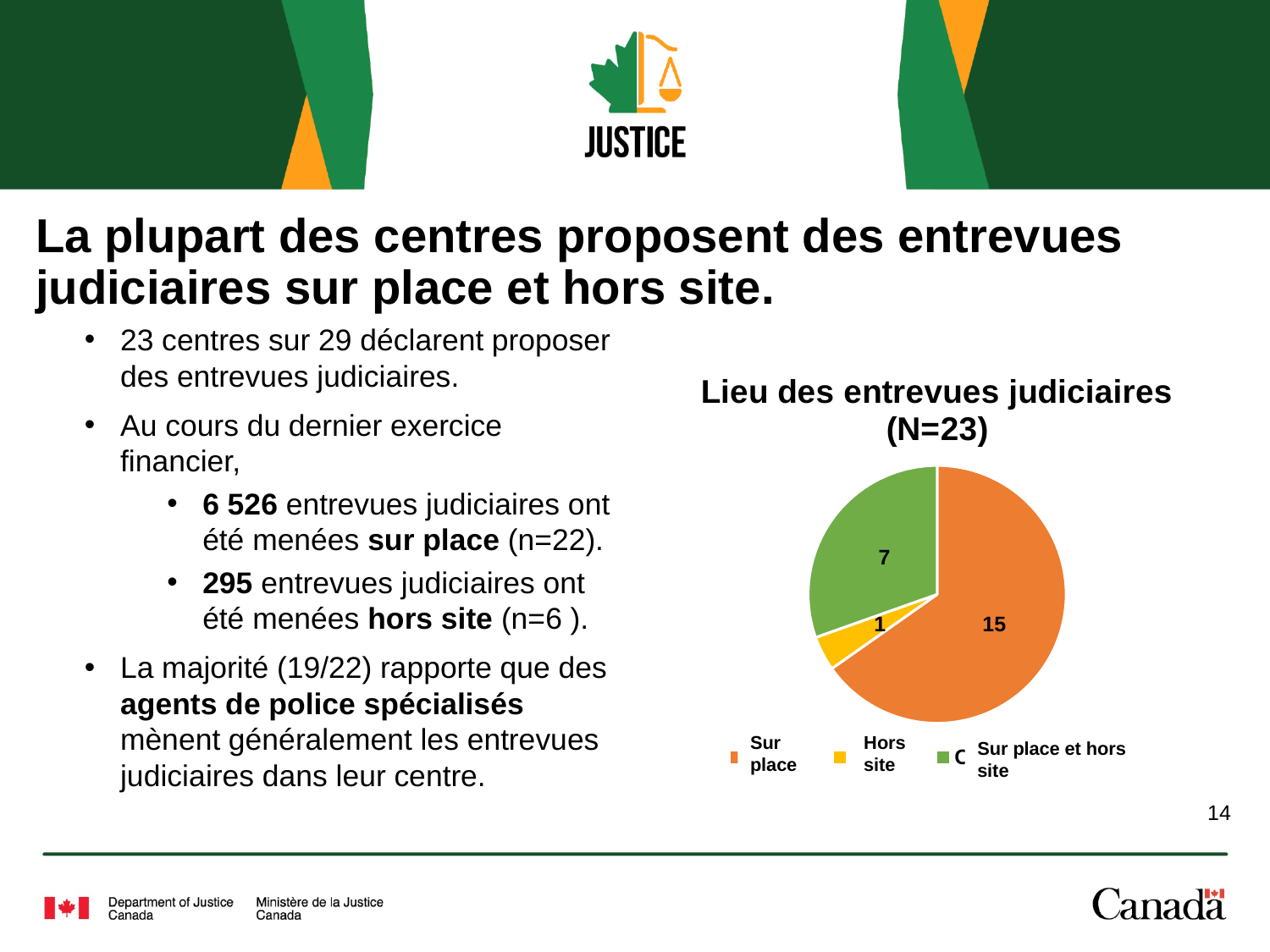
What is the difference between the values for "Sur place" and "Sur place et hors site"? 8 How many slices does the pie chart have? 3 What is the value for "Sur place" in the pie chart? 15 Which is larger, the value for "Sur place et hors site" or the value for "Hors site"? Sur place et hors site What colour is the "Hors site" slice in the pie chart? yellow What is the title of the chart? Lieu des entrevues judiciaires (N=23) What is the value for "Sur place et hors site" in the pie chart? 7 Which category has the largest slice in the pie chart? Sur place What is the value for "Hors site" in the pie chart? 1 What type of chart is shown on the slide? pie chart What share of the pie does the "Sur place" slice represent, as a fraction of the total 23? 15/23 Which category has the smallest slice in the pie chart? Hors site